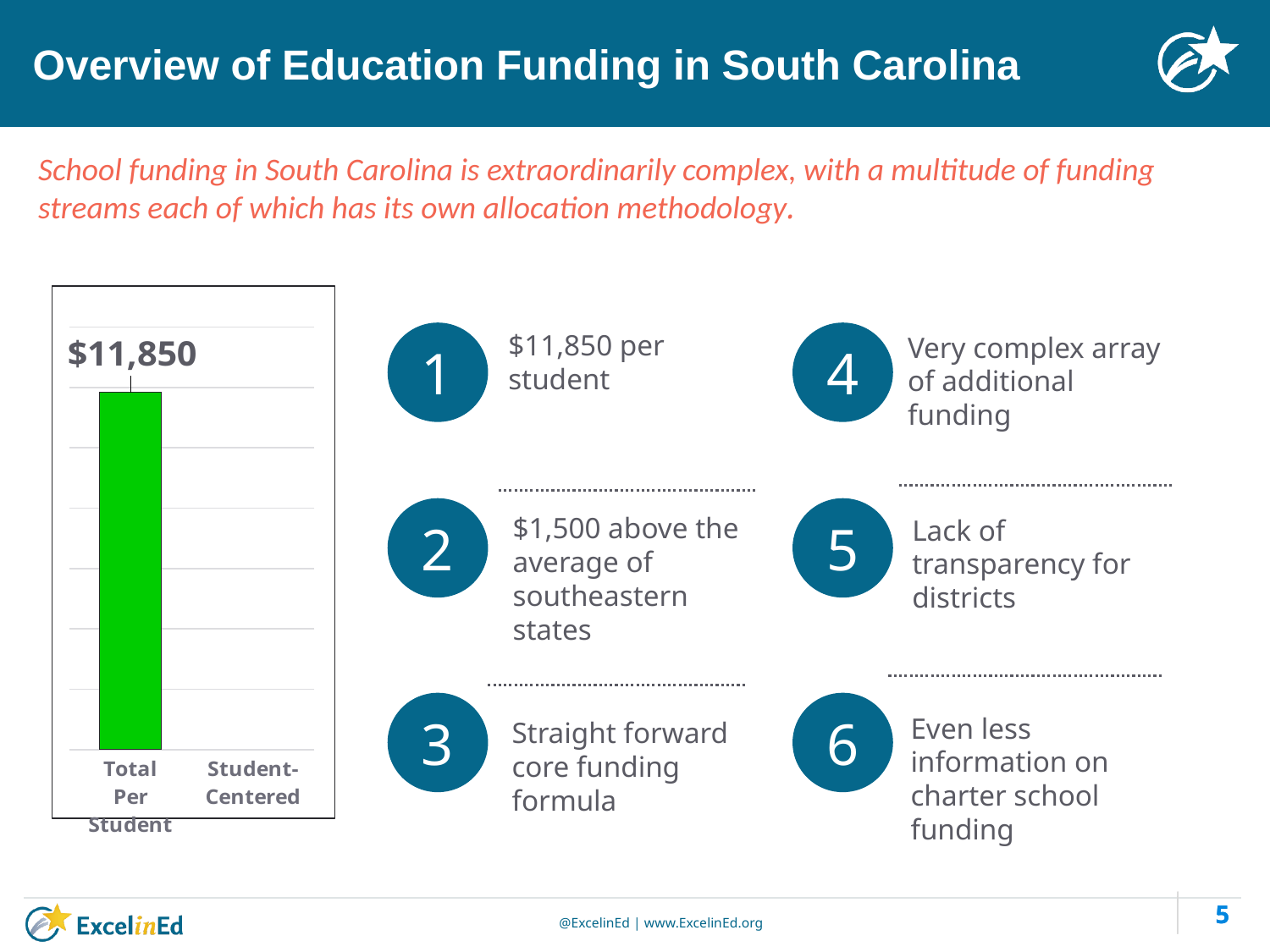
What is the value shown for Total Per Student in the chart? $11,850 What is the label of the second category on the x axis of the chart? Student-Centered How many categories are labelled on the x axis of the chart? 2 What kind of chart is shown on the left of the slide? bar chart Which category in the chart has the taller bar, Total Per Student or Student-Centered? Total Per Student Which category in the chart has the highest value? Total Per Student What colour is the bar for Total Per Student? green